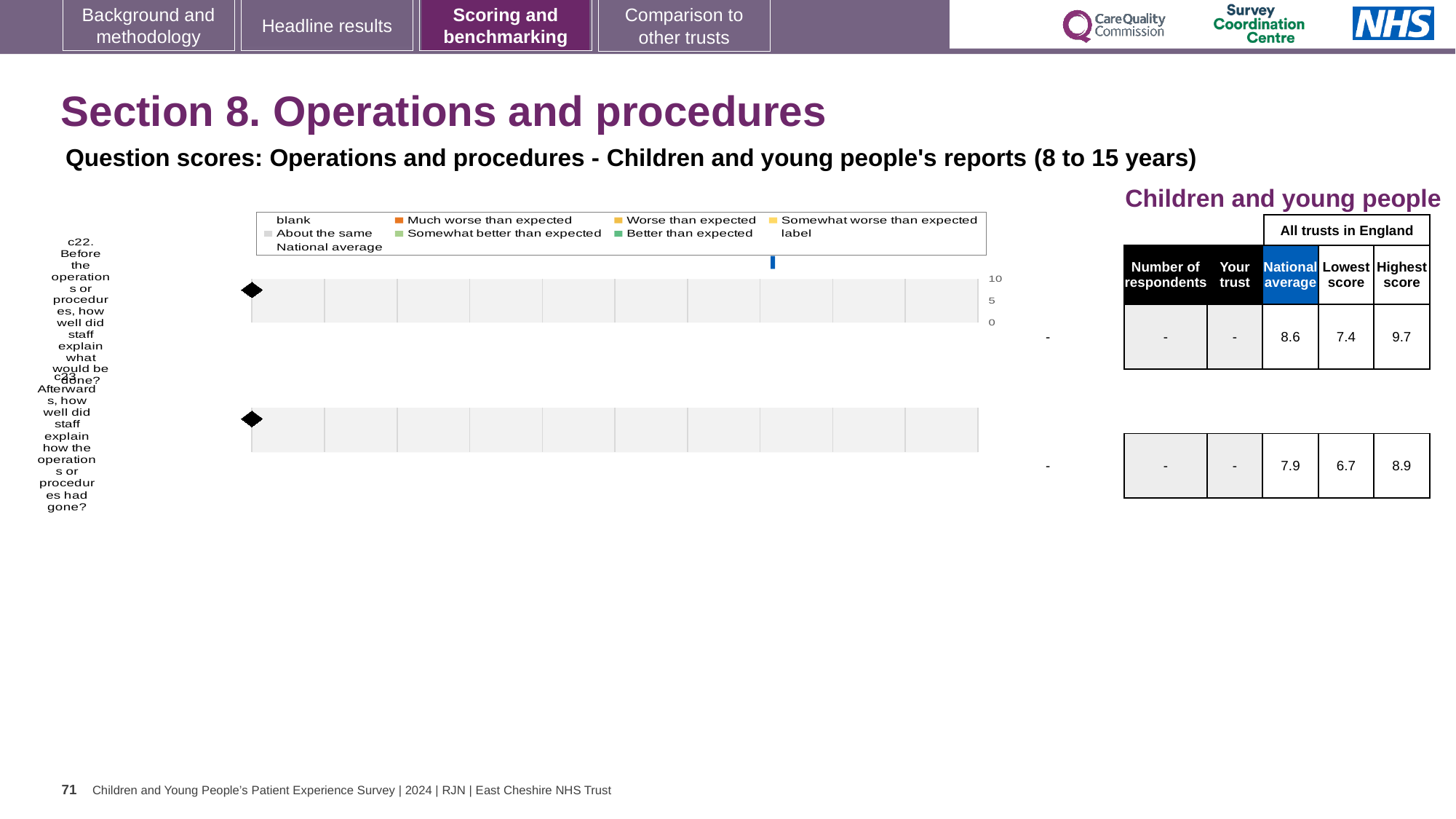
Which question has the higher national average in the table, c22 or c23? c22 Which legend entry is shown in orange? Much worse than expected How many entries does the chart legend list? 9 In the table, what is the national average score for c23 (Afterwards, how well did staff explain how the operations or procedures had gone?)? 7.9 In the table, what is the national average score for c22 (Before the operations or procedures, how well did staff explain what would be done?)? 8.6 What is the maximum value shown on the chart's axis? 10 What is the difference between the highest and lowest scores for c22 in the table? 2.3 How many question categories are plotted on the chart? 2 What kind of chart is shown on the slide? bar chart In the table, what is the lowest score across all trusts in England for c23? 6.7 In the table, what is the highest score across all trusts in England for c22? 9.7 What is the difference between the national averages for c22 and c23 in the table? 0.7